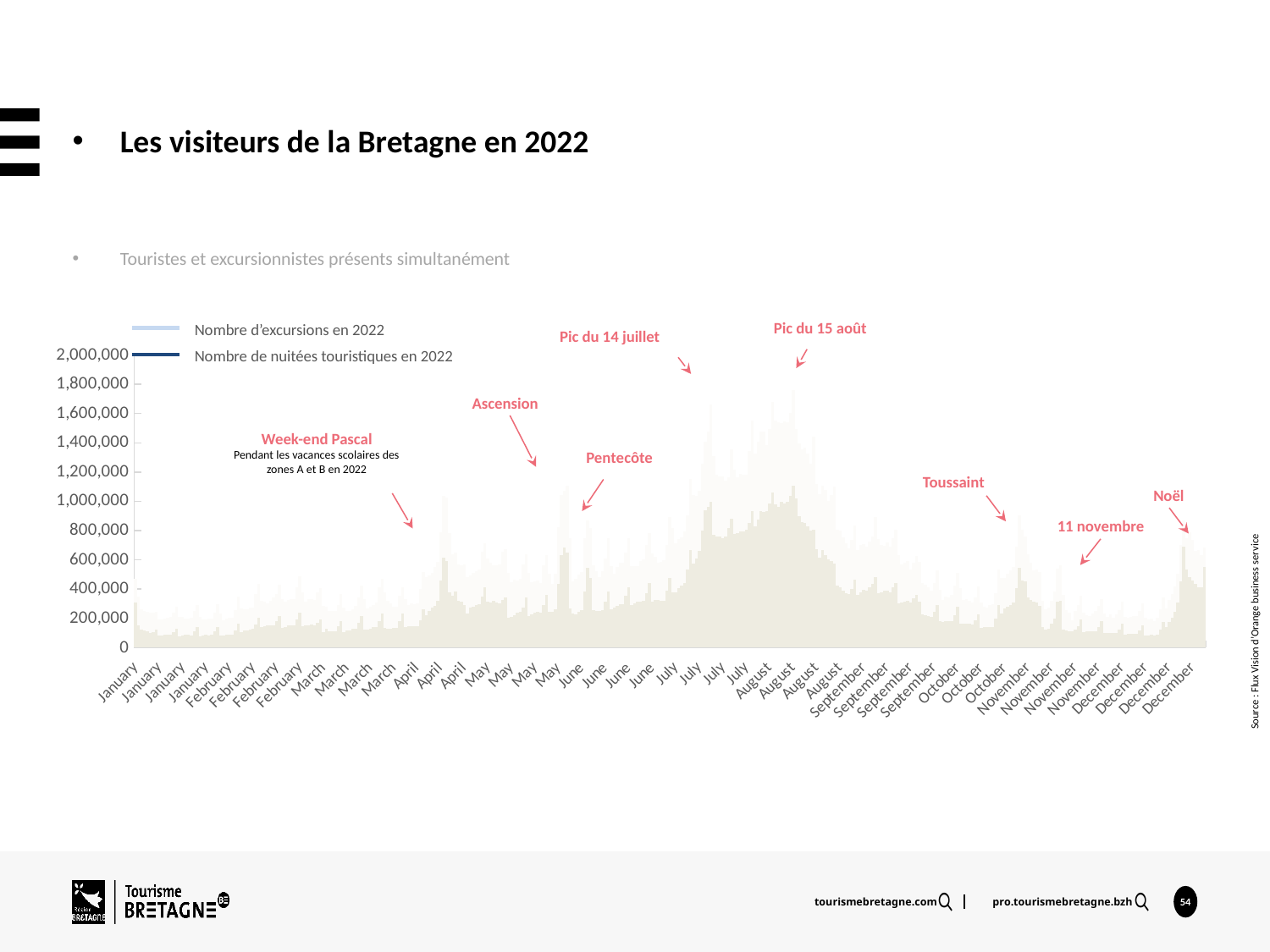
What is the title of the slide containing the chart? Les visiteurs de la Bretagne en 2022 Are the values in January greater or less than 600,000? less What are the two series named in the chart legend? Nombre d'excursions en 2022; Nombre de nuitées touristiques en 2022 Do the values generally rise or fall from August to October? fall Which is higher on the chart: the peak in August or the peak at Noël? The peak in August In which month does the chart reach its highest peak? August Which annotated event on the chart is labelled as occurring during the school holidays of zones A and B in 2022? Week-end Pascal What kind of chart is shown on the slide? Stacked bar chart Do the values generally rise or fall from January to August? rise How many series does the chart legend list? 2 Is the peak value around 'Pic du 15 août' greater or less than 1,000,000? greater What is the highest value shown on the chart's vertical axis? 2,000,000